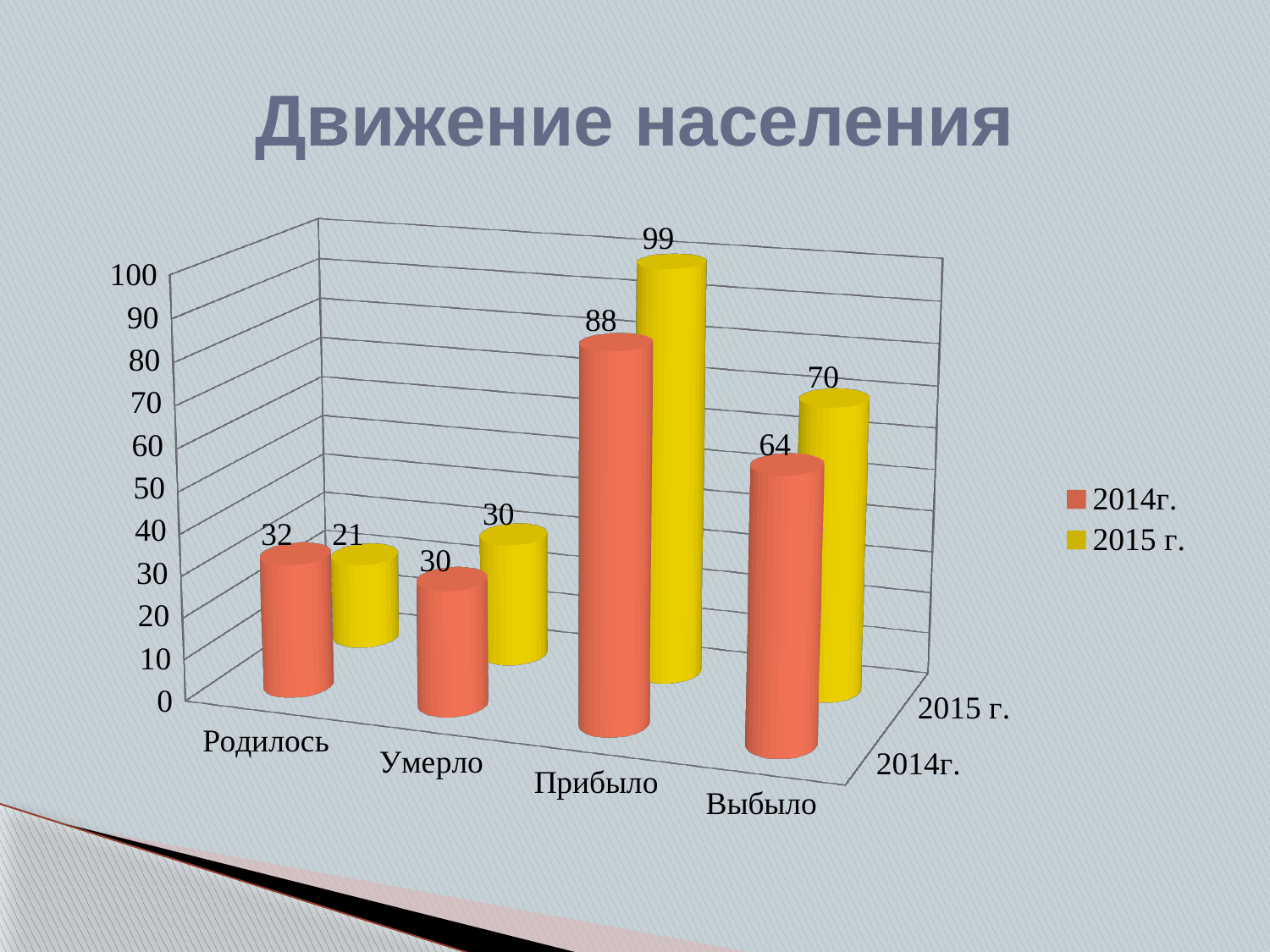
Which category has the lowest value in the 2014г. series? Умерло What kind of chart is shown on the slide? bar chart What is the difference between the 2015 г. and 2014г. values for Прибыло? 11 Which is larger for Выбыло: the 2014г. value or the 2015 г. value? 2015 г. How many categories are shown on the x axis? 4 What is the difference between the 2014г. and 2015 г. values for Родилось? 11 How many series does the legend list? 2 What is the value for Выбыло in the 2015 г. series? 70 What is the title of the chart? Движение населения Which category has the highest value in the 2015 г. series? Прибыло What is the value for Прибыло in the 2014г. series? 88 What is the value for Родилось in the 2015 г. series? 21